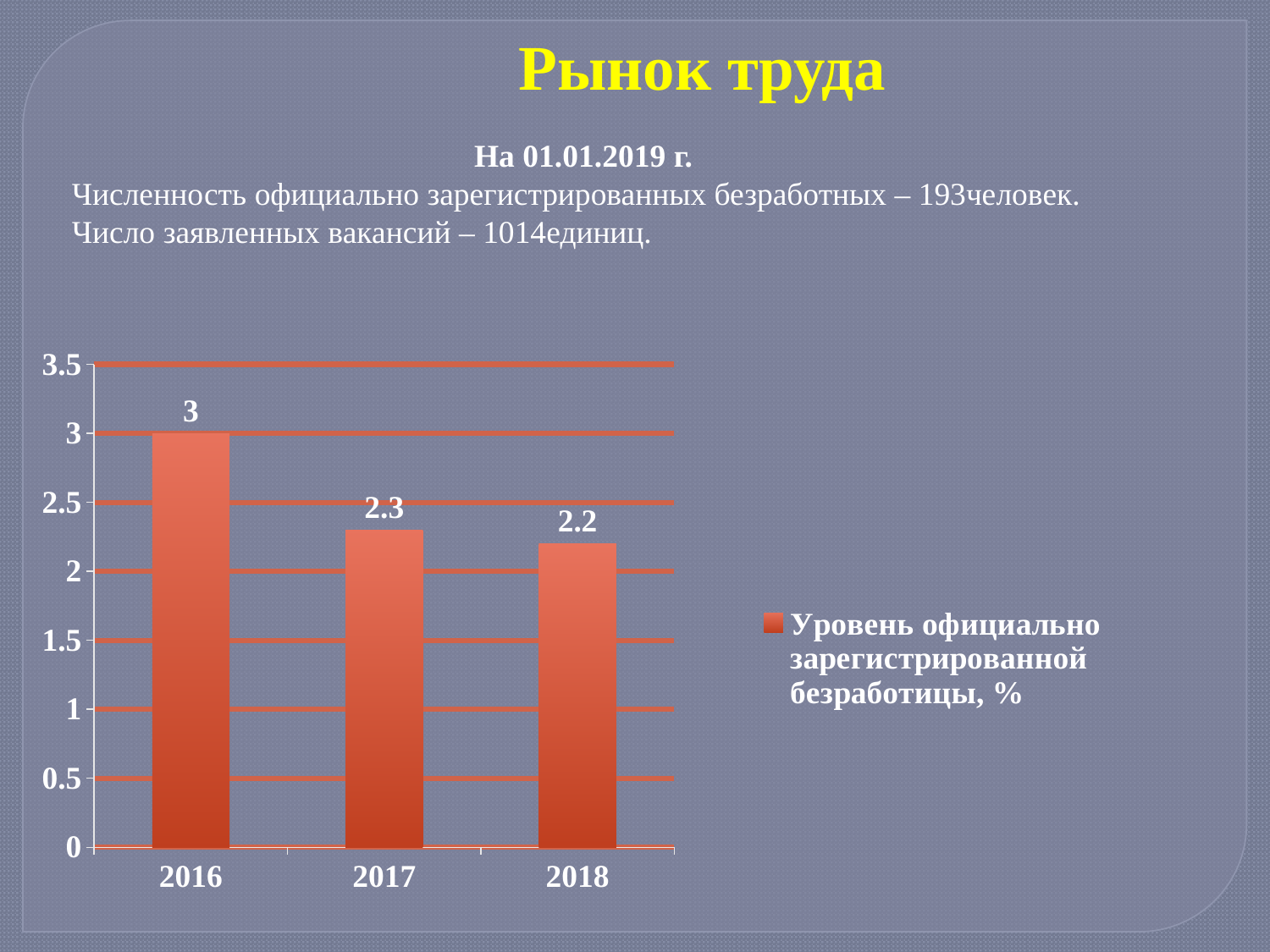
Do the values rise or fall from 2016 to 2018? fall Which year has the highest value? 2016 What kind of chart is shown? bar chart Which is larger, the value for 2016 or the value for 2017? 2016 What is the difference between the values for 2017 and 2018? 0.1 What is the difference between the values for 2016 and 2018? 0.8 Which year has the lowest value? 2018 What is the value for 2016? 3 What is the value for 2018? 2.2 How many years are shown on the x axis? 3 Is the value for 2017 greater or less than 2.5? less What is the value for 2017? 2.3